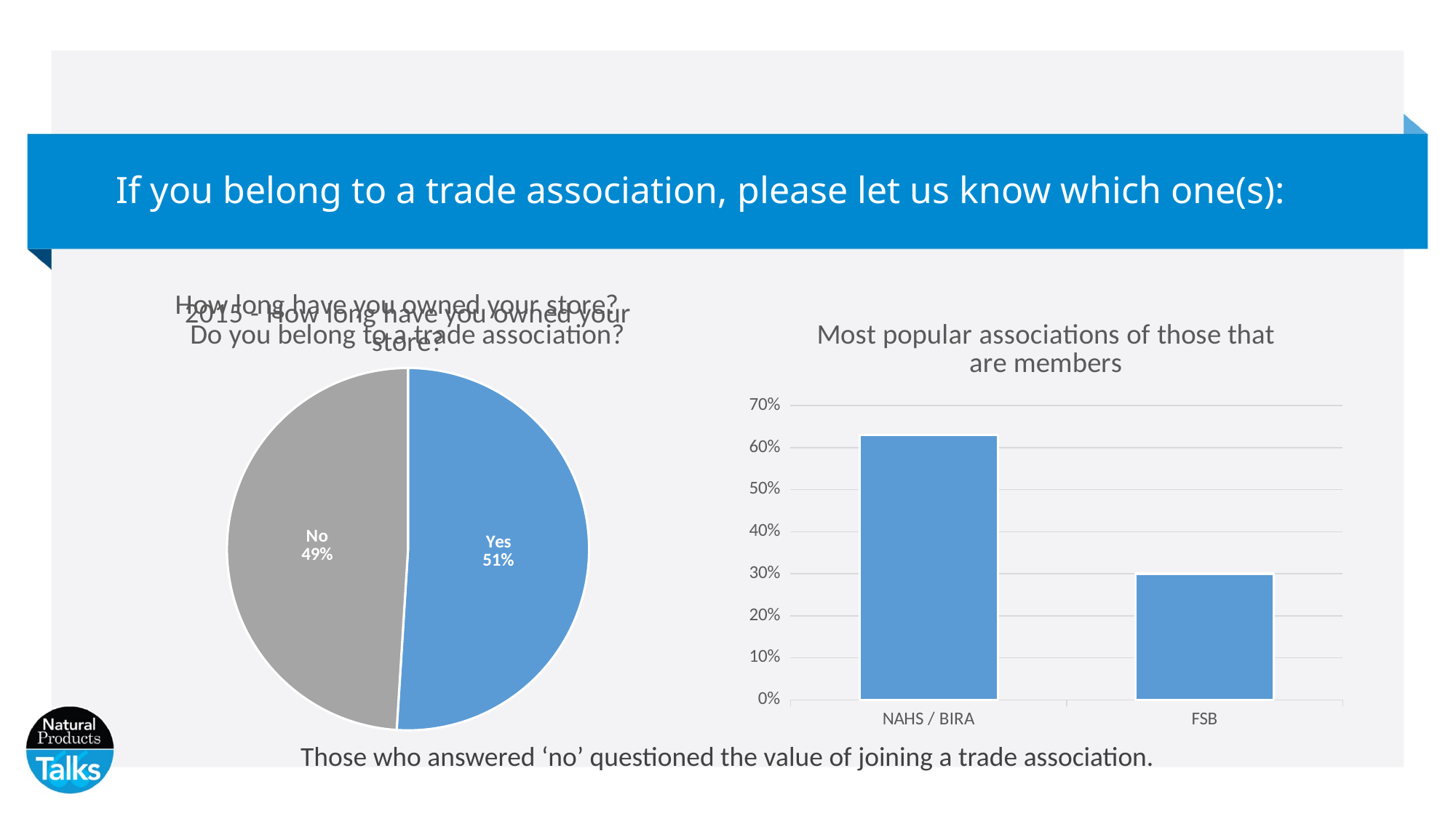
In the pie chart on the left, which answer has the larger share, 'Yes' or 'No'? Yes In the pie chart on the left, what share of respondents answered 'No'? 49% What kind of chart is 'Most popular associations of those that are members'? Bar chart In the pie chart on the left, how many percentage points larger is the 'Yes' share than the 'No' share? 2 How many categories are shown in the chart 'Most popular associations of those that are members'? 2 In the chart 'Most popular associations of those that are members', is the value for NAHS / BIRA greater or less than 60%? greater In the chart 'Most popular associations of those that are members', which association has the lowest value? FSB What kind of chart is the chart on the left of the slide? Pie chart How many slices does the pie chart on the left have? 2 In the chart 'Most popular associations of those that are members', which association has the highest value? NAHS / BIRA In the chart 'Most popular associations of those that are members', is the value for FSB greater or less than 40%? less In the pie chart on the left, what share of respondents answered 'Yes'? 51%